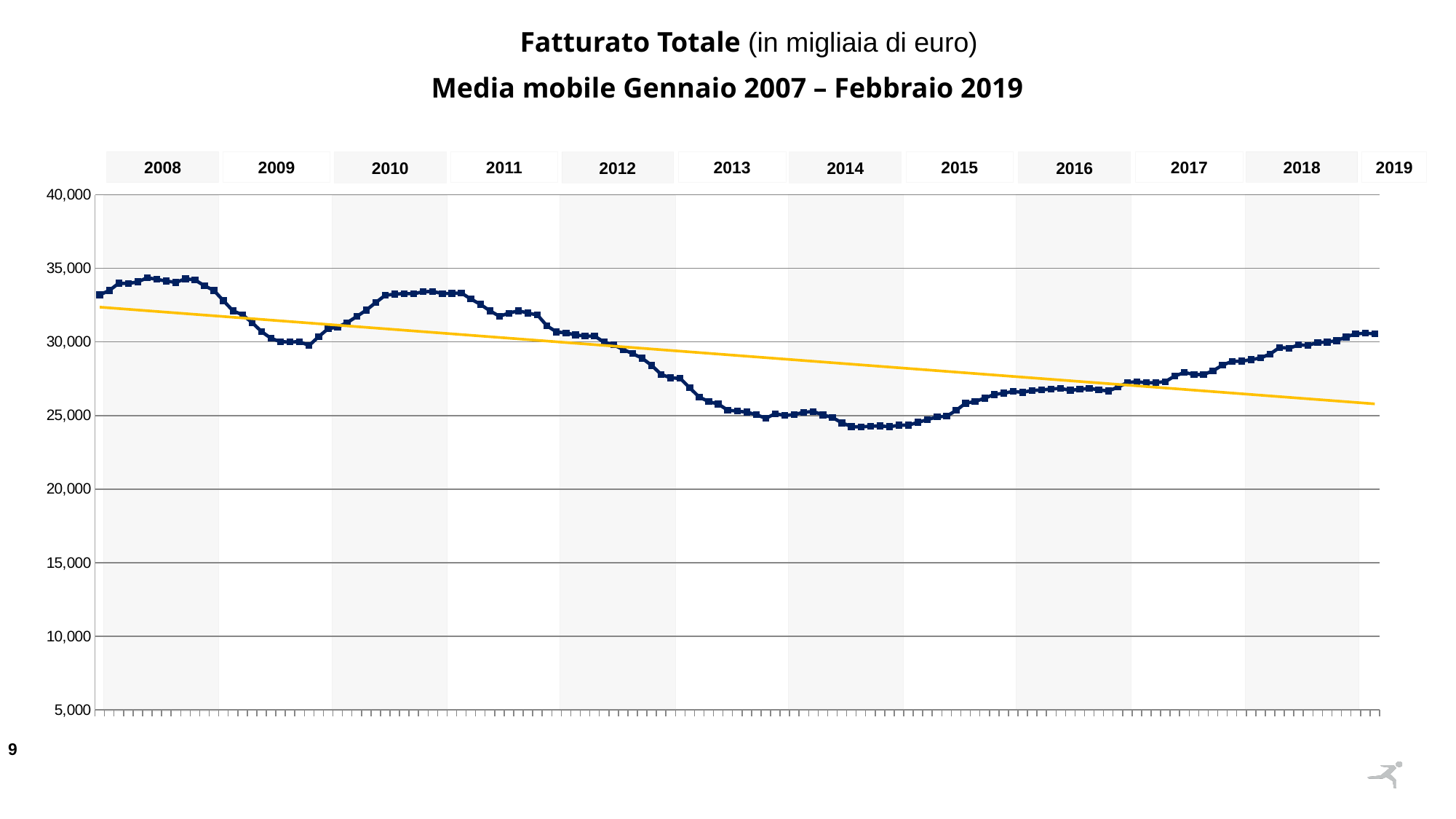
What kind of chart is shown on the slide? line chart Does the yellow trend line rise or fall from left to right? fall In which year does the blue line reach its highest point? 2008 Is the value of the blue line at its peak in 2008 greater or less than 30,000? greater What is the title of the chart? Fatturato Totale (in migliaia di euro) – Media mobile Gennaio 2007 – Febbraio 2019 Is the value of the blue line at its lowest point in 2014 greater or less than 25,000? less Does the blue line rise or fall between 2014 and 2019? rise What is the highest value shown on the vertical axis? 40,000 Which is higher on the blue line: the peak in 2008 or the trough in 2014? the peak in 2008 Is the value of the blue line at the start of 2019 greater or less than 30,000? greater In which year does the blue line reach its lowest point? 2014 How many year labels are shown along the top of the chart? 12